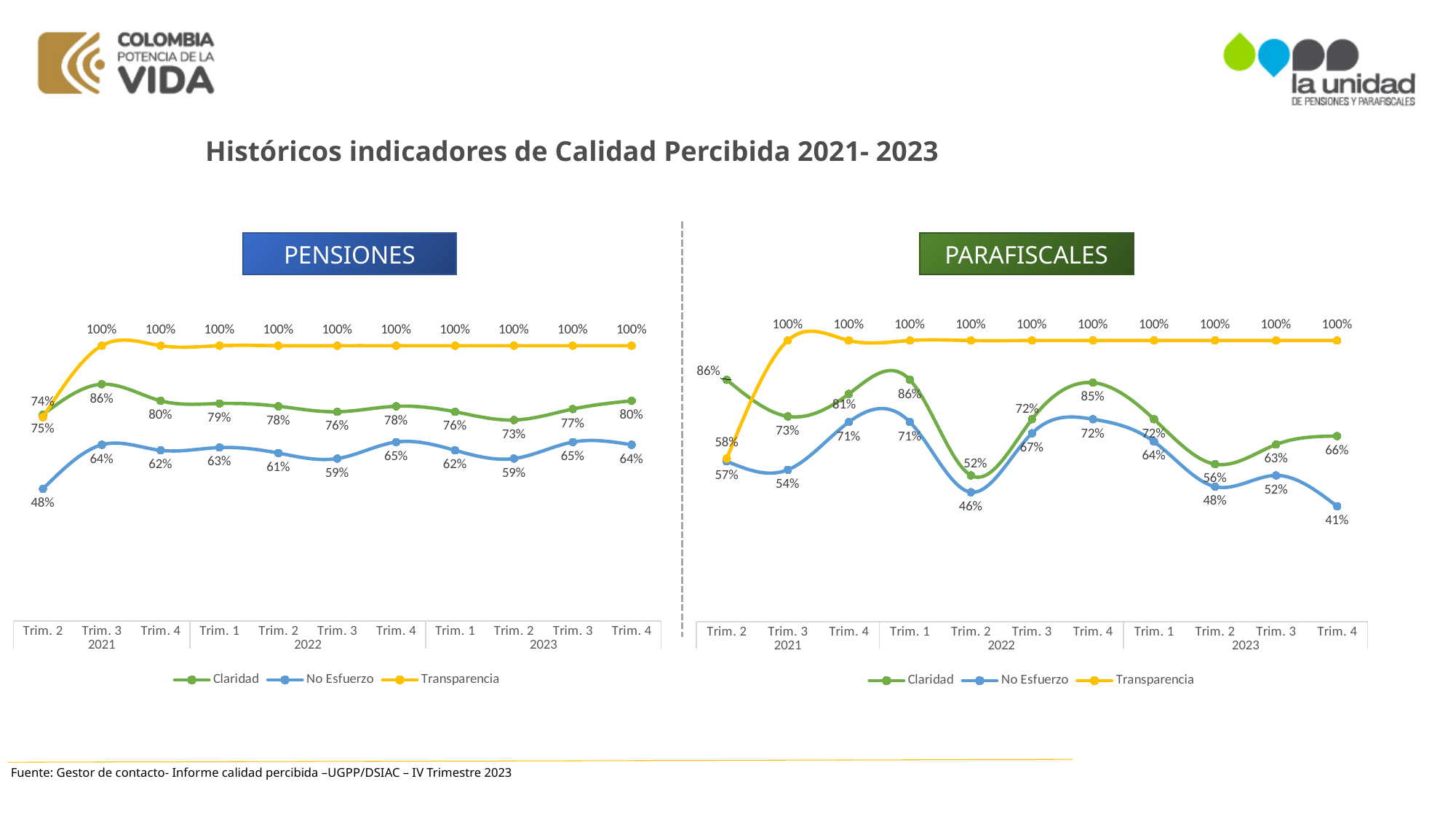
In the PENSIONES chart, which is larger, the No Esfuerzo value for Trim. 4 2022 or for Trim. 3 2022? Trim. 4 2022 In the PENSIONES chart, which quarter has the highest Claridad value? Trim. 3 2021 In the PARAFISCALES chart, what is the difference between the Claridad and No Esfuerzo values for Trim. 4 2022? 13% In the PARAFISCALES chart, what is the No Esfuerzo value for Trim. 4 2023? 41% What kind of chart is the PARAFISCALES chart? Line chart In the PENSIONES chart, what is the Claridad value for Trim. 3 2021? 86% In the PENSIONES chart, what is the No Esfuerzo value for Trim. 2 2021? 48% How many quarters are plotted on the x axis of the PARAFISCALES chart? 11 In the PARAFISCALES chart, does the No Esfuerzo value rise or fall from Trim. 1 2023 to Trim. 2 2023? Fall In the PARAFISCALES chart, which quarter has the lowest No Esfuerzo value? Trim. 4 2023 How many series does the legend of the PENSIONES chart list? 3 In the PARAFISCALES chart, what is the Claridad value for Trim. 2 2022? 52%